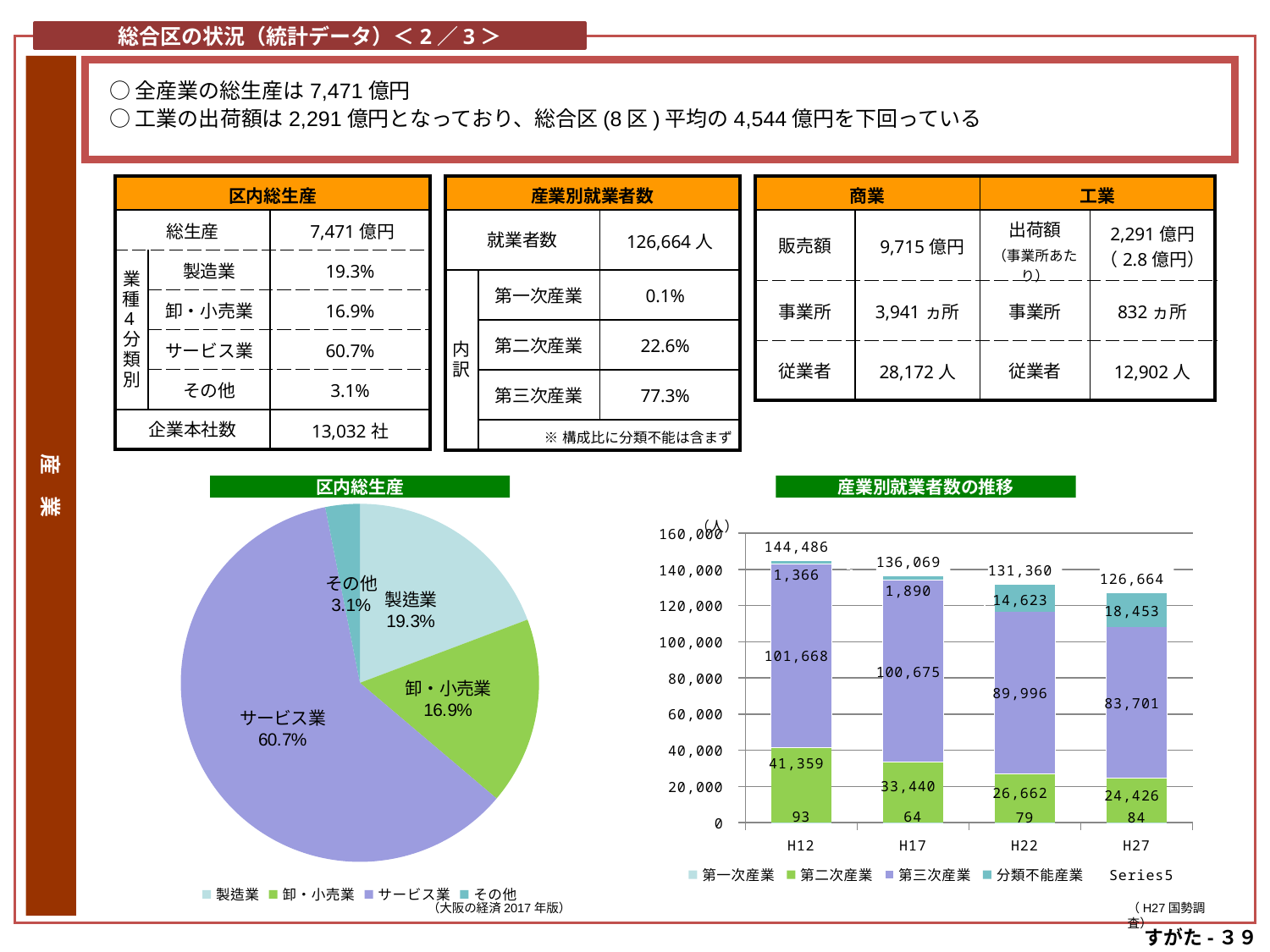
In the 区内総生産 pie chart, which category has the smallest share? その他 In the 産業別就業者数の推移 chart, which year has the highest total? H12 In the 区内総生産 pie chart, what is the difference between the shares of 製造業 and 卸・小売業? 2.4% In the 区内総生産 pie chart, what share does サービス業 have? 60.7% In the 区内総生産 pie chart, how many slices are there? 4 In the 産業別就業者数の推移 chart, is 分類不能産業 larger in H22 or H27? H27 What kind of chart is the 産業別就業者数の推移 chart? Stacked bar chart How many entries does the legend of the 産業別就業者数の推移 chart list? 5 In the 産業別就業者数の推移 chart, what is the value for 第三次産業 in H22? 89,996 In the 産業別就業者数の推移 chart, what is the difference in 第二次産業 between H12 and H27? 16,933 In the 産業別就業者数の推移 chart, what is the total for H27? 126,664 In the 産業別就業者数の推移 chart, how do the totals change from H12 to H27? They fall